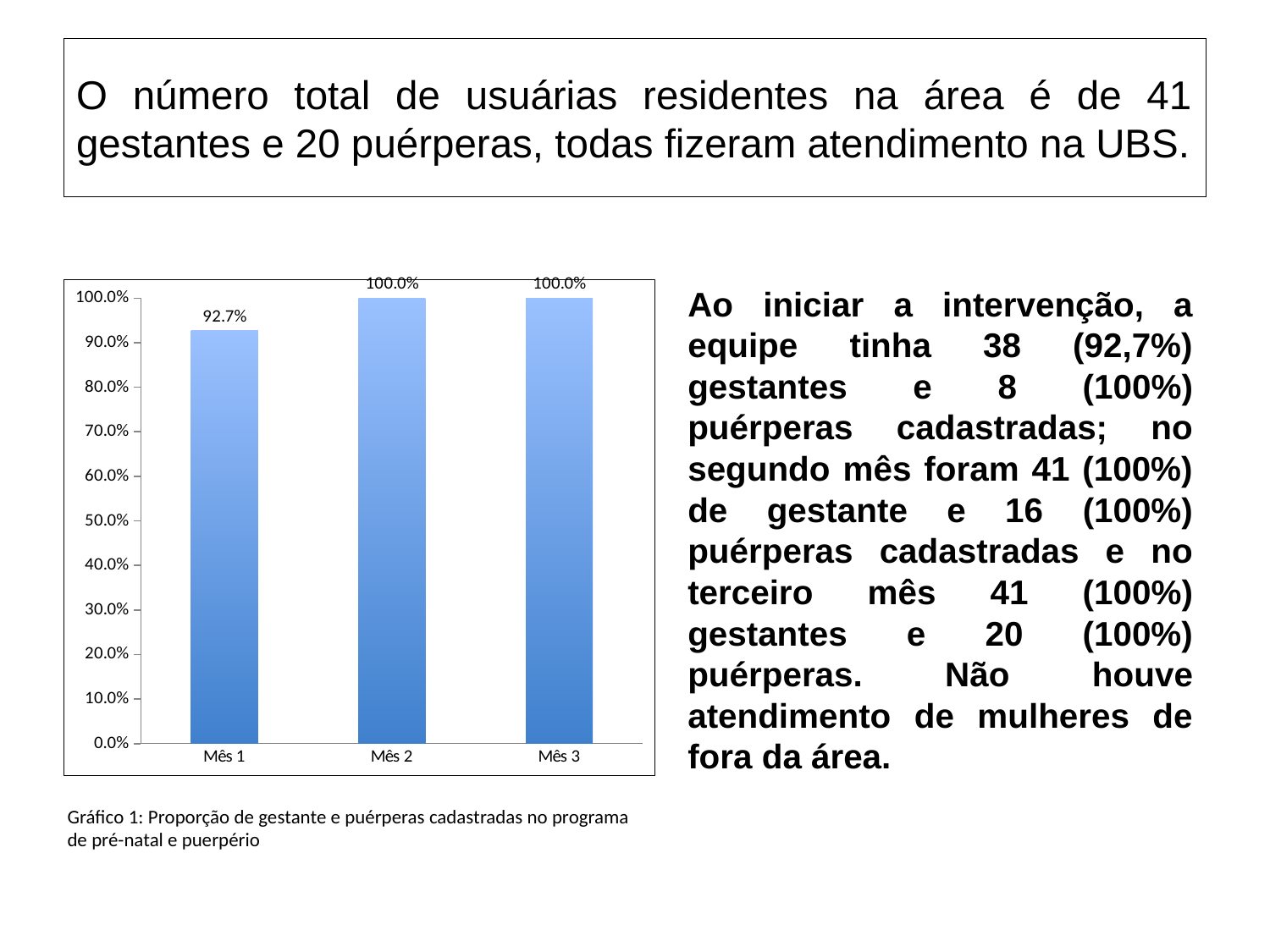
Which is larger, the value for Mês 1 or the value for Mês 3? Mês 3 What is the highest tick value shown on the y axis? 100.0% What is the difference between the values for Mês 2 and Mês 1? 7.3% What kind of chart is shown on the slide? bar chart What is the value for Mês 2? 100.0% Do the values rise or fall from Mês 1 to Mês 2? rise What is the value for Mês 1? 92.7% How many categories are shown on the x axis? 3 What is the value for Mês 3? 100.0% Which category has the lowest value? Mês 1 What is the caption given for the chart below it? Gráfico 1: Proporção de gestante e puérperas cadastradas no programa de pré-natal e puerpério Is the value for Mês 1 greater or less than 90.0%? greater